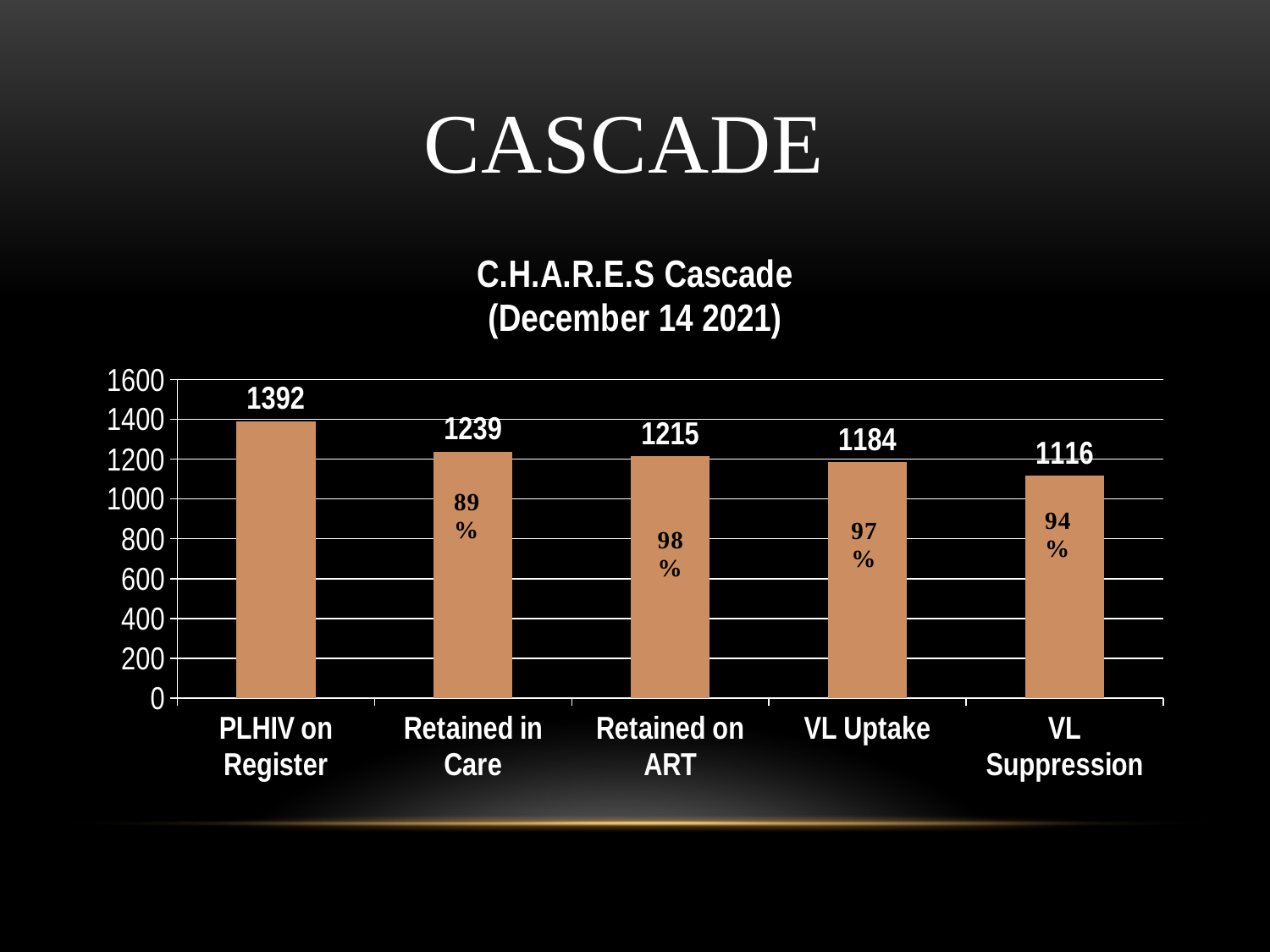
How many categories are shown on the chart? 5 What is the value for Retained in Care? 1239 Which category has the lowest value? VL Suppression What is the difference between PLHIV on Register and Retained on ART? 177 Which category has the highest value? PLHIV on Register Do the values rise or fall from left to right across the categories? Fall What is the value for VL Suppression? 1116 What kind of chart is shown? Bar chart Which is larger, Retained in Care or VL Uptake? Retained in Care What is the value for VL Uptake? 1184 What percentage is printed inside the Retained on ART bar? 98% What is the value for PLHIV on Register? 1392